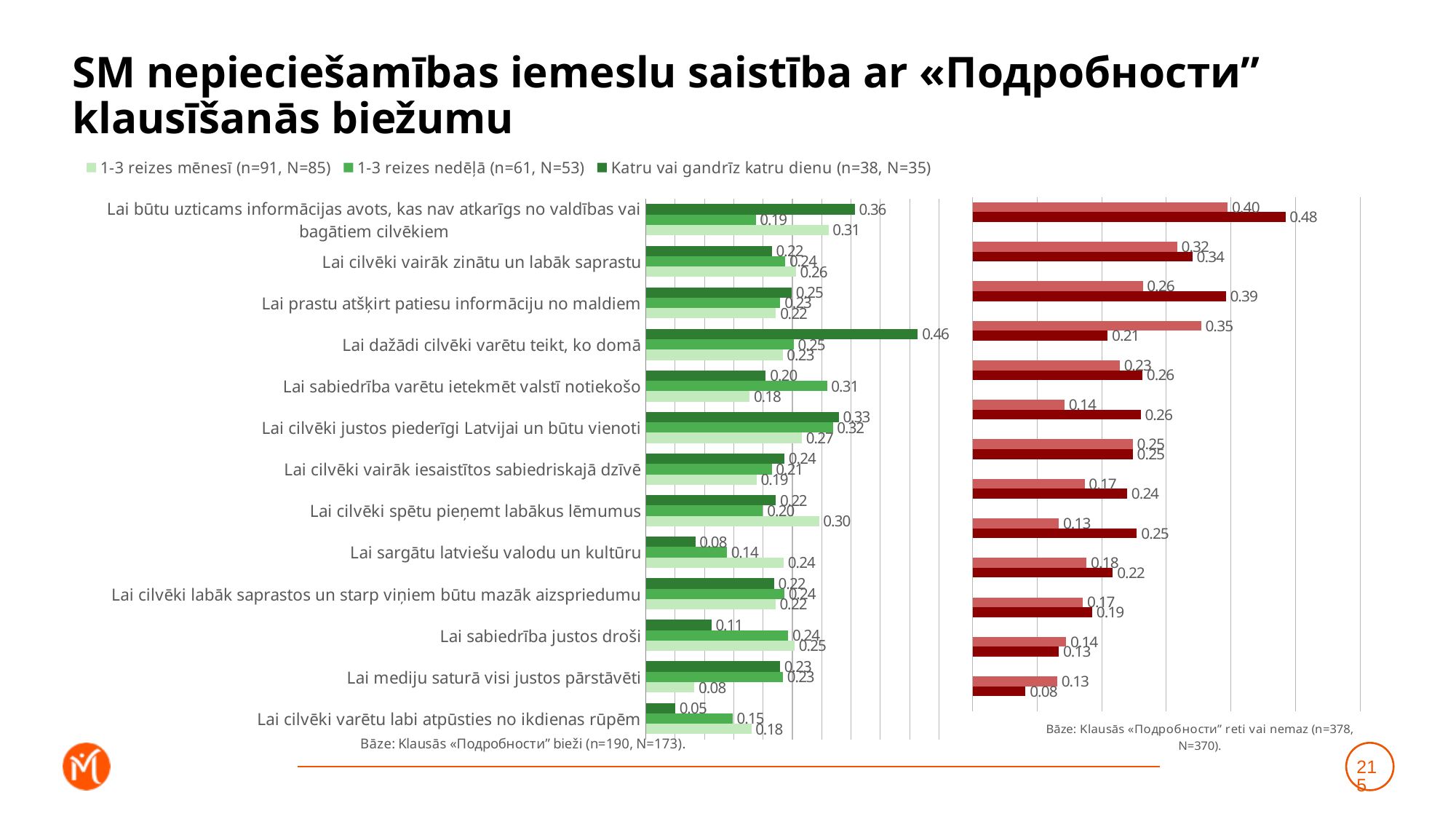
In the left (green) chart, for 'Lai būtu uzticams informācijas avots...', which is larger: the '1-3 reizes nedēļā' value or the '1-3 reizes mēnesī' value? 1-3 reizes mēnesī In the left (green) chart, what is the value for '1-3 reizes nedēļā' for 'Lai sabiedrība varētu ietekmēt valstī notiekošo'? 0.31 In the left (green) chart, what is the value for '1-3 reizes mēnesī' for 'Lai cilvēki spētu pieņemt labākus lēmumus'? 0.30 How many series does the legend of the left (green) chart list? 3 In the left (green) chart, what is the difference between the 'Katru vai gandrīz katru dienu' and '1-3 reizes mēnesī' values for 'Lai sargātu latviešu valodu un kultūru'? 0.16 In the left (green) chart, what is the value for 'Katru vai gandrīz katru dienu' for 'Lai dažādi cilvēki varētu teikt, ko domā'? 0.46 How many categories are shown in the left (green) chart? 13 In the right (red) chart, what is the value of the dark red bar for the first category, 'Lai būtu uzticams informācijas avots...'? 0.48 What type of chart is the left (green) chart? Bar chart In the right (red) chart, what is the value of the lighter red bar for 'Lai dažādi cilvēki varētu teikt, ko domā'? 0.35 In the left (green) chart, which category has the lowest value for 'Katru vai gandrīz katru dienu'? Lai cilvēki varētu labi atpūsties no ikdienas rūpēm In the left (green) chart, which category has the highest value for 'Katru vai gandrīz katru dienu'? Lai dažādi cilvēki varētu teikt, ko domā